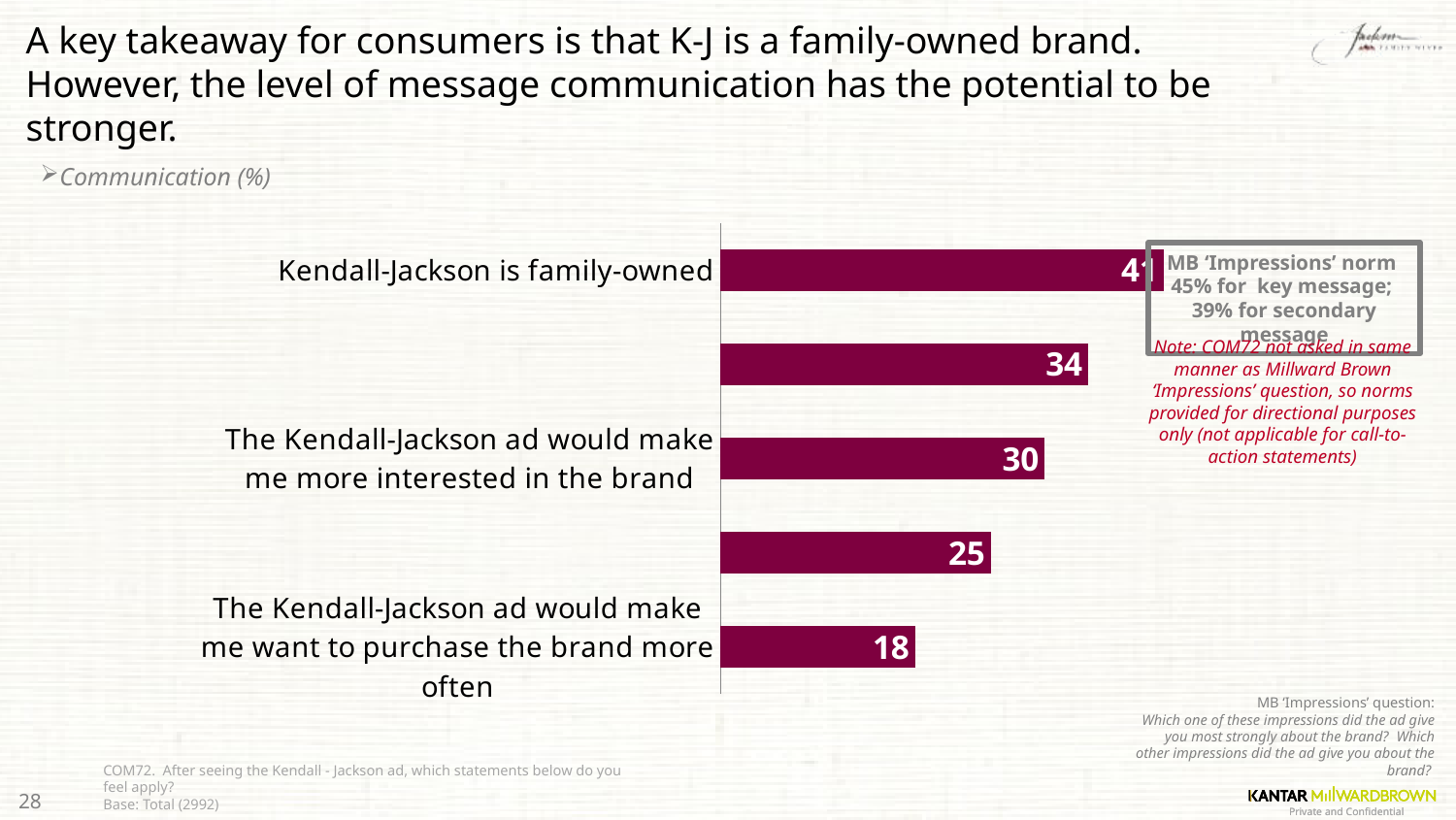
How many bars are plotted in the chart? 5 What is the value for "The Kendall-Jackson ad would make me want to purchase the brand more often"? 18 Which statement has the highest value in the chart? Kendall-Jackson is family-owned What is the difference between the value for "The Kendall-Jackson ad would make me more interested in the brand" and the value for "The Kendall-Jackson ad would make me want to purchase the brand more often"? 12 Which is larger: the value for "Kendall-Jackson is family-owned" or the value for "The Kendall-Jackson ad would make me more interested in the brand"? Kendall-Jackson is family-owned What colour are the bars in the chart? maroon What kind of chart is shown on the slide? bar chart Which statement has the lowest value in the chart? The Kendall-Jackson ad would make me want to purchase the brand more often What is the value for "The Kendall-Jackson ad would make me more interested in the brand"? 30 Do the bar values increase or decrease going from the top bar to the bottom bar? decrease What is the title of the chart? Communication (%)